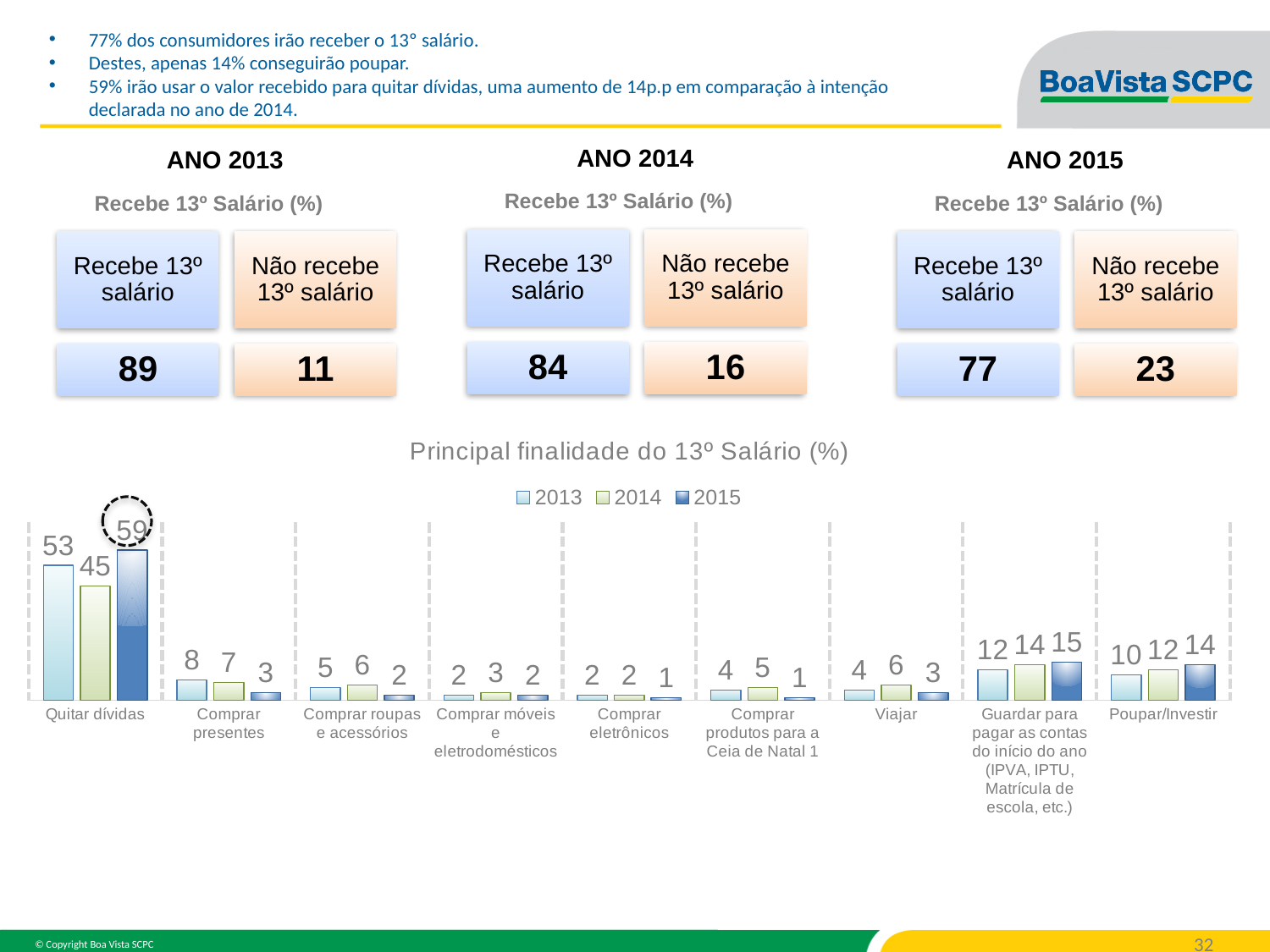
In the chart 'Principal finalidade do 13º Salário (%)', which category has the lowest value for 2013? Comprar móveis e eletrodomésticos and Comprar eletrônicos (both 2) In the chart 'Principal finalidade do 13º Salário (%)', which category has the highest value for 2015? Quitar dívidas In the chart 'Principal finalidade do 13º Salário (%)', which is larger for 'Comprar presentes': the 2013 value or the 2015 value? 2013 In the chart 'Principal finalidade do 13º Salário (%)', what is the value for 'Quitar dívidas' in 2015? 59 In the chart 'Principal finalidade do 13º Salário (%)', how many series does the legend list? 3 In the chart 'Principal finalidade do 13º Salário (%)', which series does the legend list first? 2013 In the chart 'Principal finalidade do 13º Salário (%)', what is the 2014 value for 'Viajar'? 6 In the chart 'Principal finalidade do 13º Salário (%)', how many categories are shown on the x axis? 9 In the chart 'Principal finalidade do 13º Salário (%)', what is the difference between the 2015 and 2014 values for 'Quitar dívidas'? 14 In the chart 'Principal finalidade do 13º Salário (%)', do the values for 'Poupar/Investir' rise or fall from 2013 to 2015? Rise In the chart 'Principal finalidade do 13º Salário (%)', what is the value for 'Poupar/Investir' in 2013? 10 What kind of chart is 'Principal finalidade do 13º Salário (%)'? Bar chart